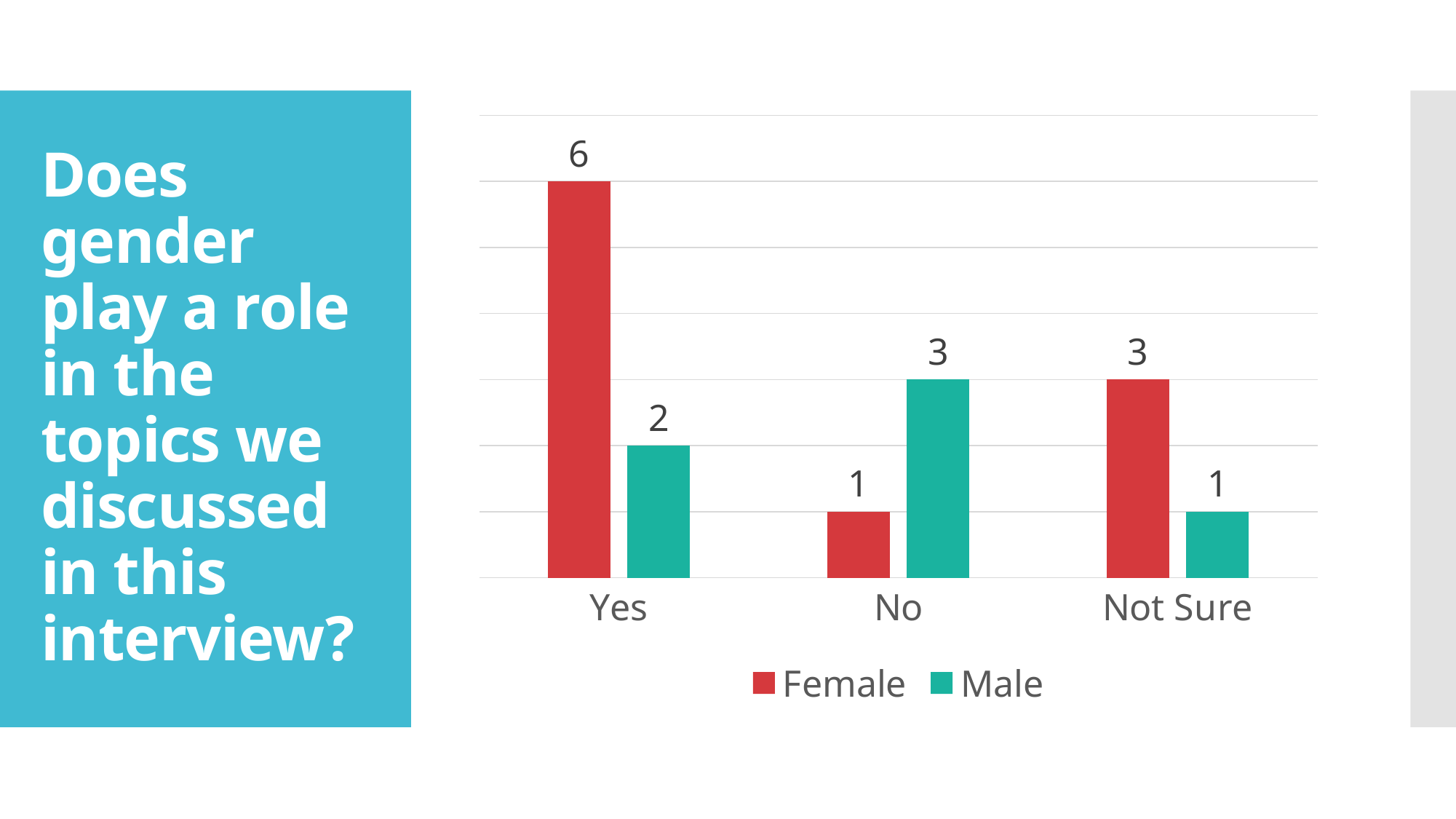
What is the Male value for No? 3 Which colour represents the Male series? Green What is the Male value for Not Sure? 1 Which category has the highest Female value? Yes What is the difference between the Female and Male values for Yes? 4 For No, which is larger, the Female value or the Male value? Male Which category has the lowest Female value? No What kind of chart is shown on the slide? Bar chart What is the Female value for Not Sure? 3 What is the Female value for Yes? 6 How many series does the legend list? 2 How many categories are shown on the x axis? 3